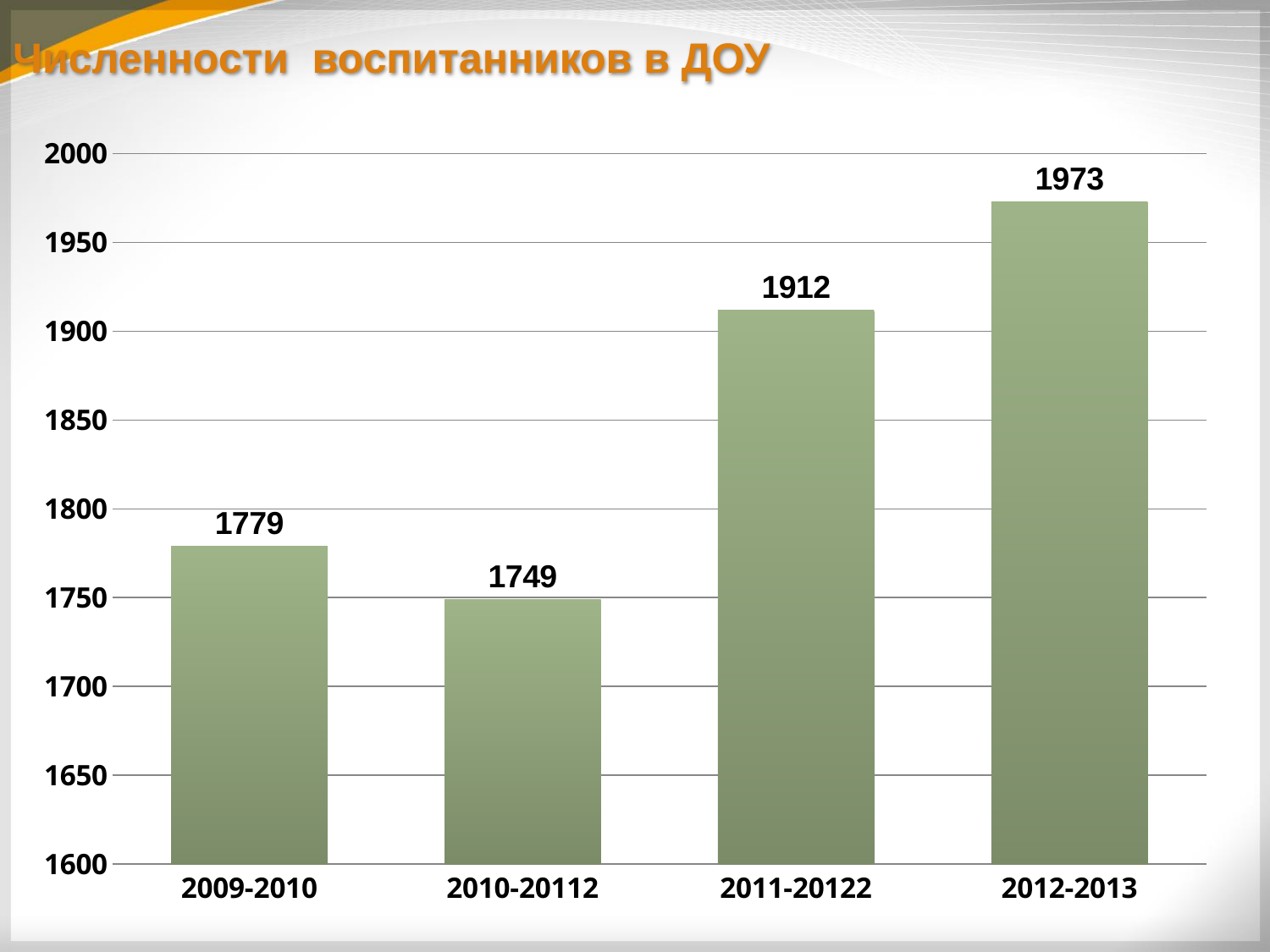
What is the value for 2011-20122? 1912 Which category has the lowest value? 2010-20112 What is the value for 2010-20112? 1749 What is the difference between the values for 2012-2013 and 2011-20122? 61 What is the difference between the values for 2009-2010 and 2010-20112? 30 What is the title of the chart? Численности воспитанников в ДОУ Which is larger, the value for 2009-2010 or the value for 2011-20122? 2011-20122 What is the value for 2009-2010? 1779 What kind of chart is shown on the slide? bar chart What is the value for 2012-2013? 1973 Which category has the highest value? 2012-2013 How many categories are shown on the x axis? 4